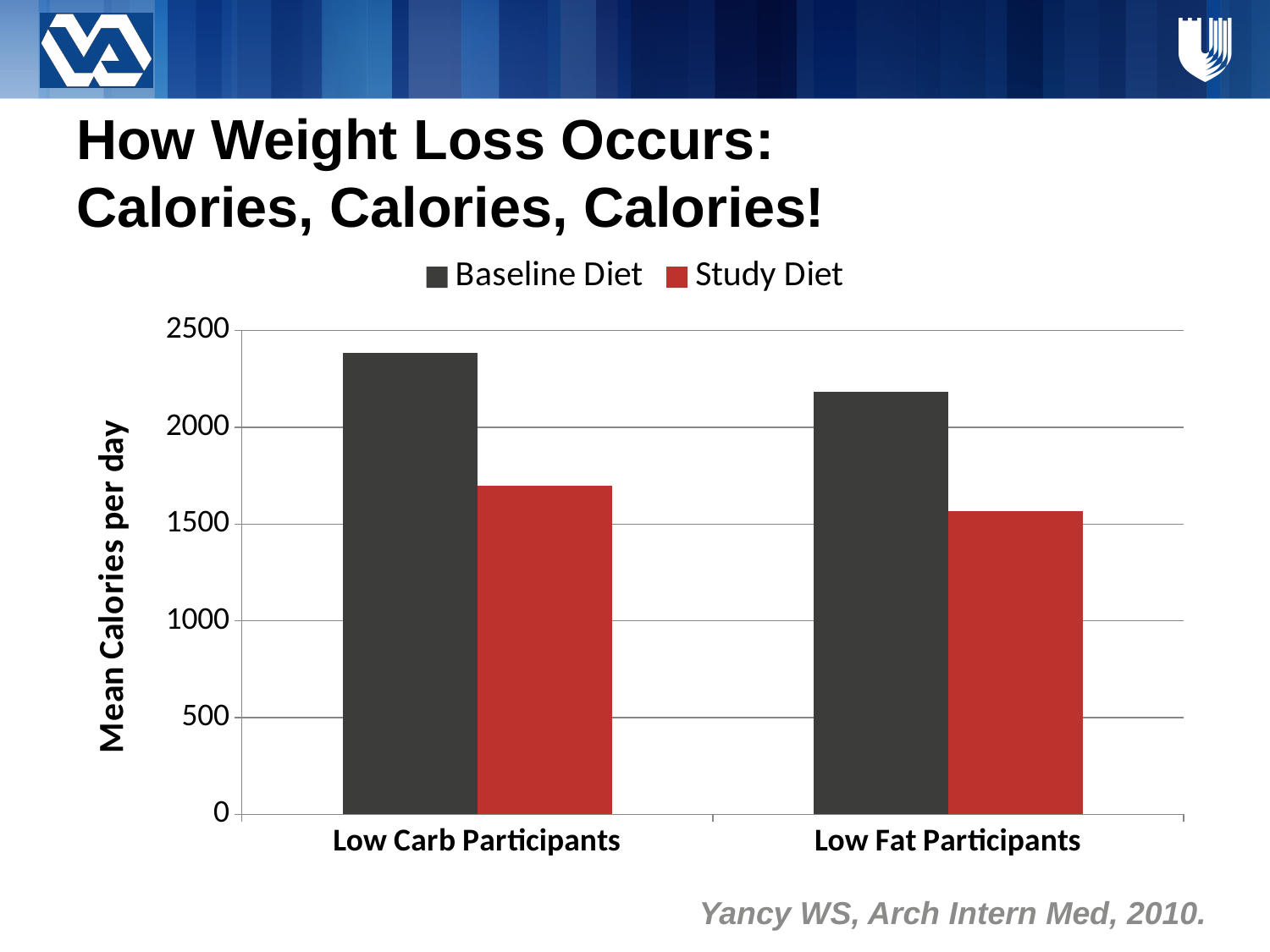
Which bar in the chart is the lowest? Study Diet for Low Fat Participants What kind of chart is shown on the slide? bar chart For Low Fat Participants, which is larger: the Baseline Diet value or the Study Diet value? Baseline Diet How many participant groups are shown on the x axis of the chart? 2 Which series is shown in red in the chart? Study Diet How many series does the chart legend list? 2 Is the Study Diet value for Low Carb Participants greater or less than 2000? less What is the label of the y axis of the chart? Mean Calories per day Is the Baseline Diet value for Low Carb Participants greater or less than 2000? greater Which bar in the chart is the highest? Baseline Diet for Low Carb Participants Is the Study Diet value for Low Fat Participants greater or less than 2000? less